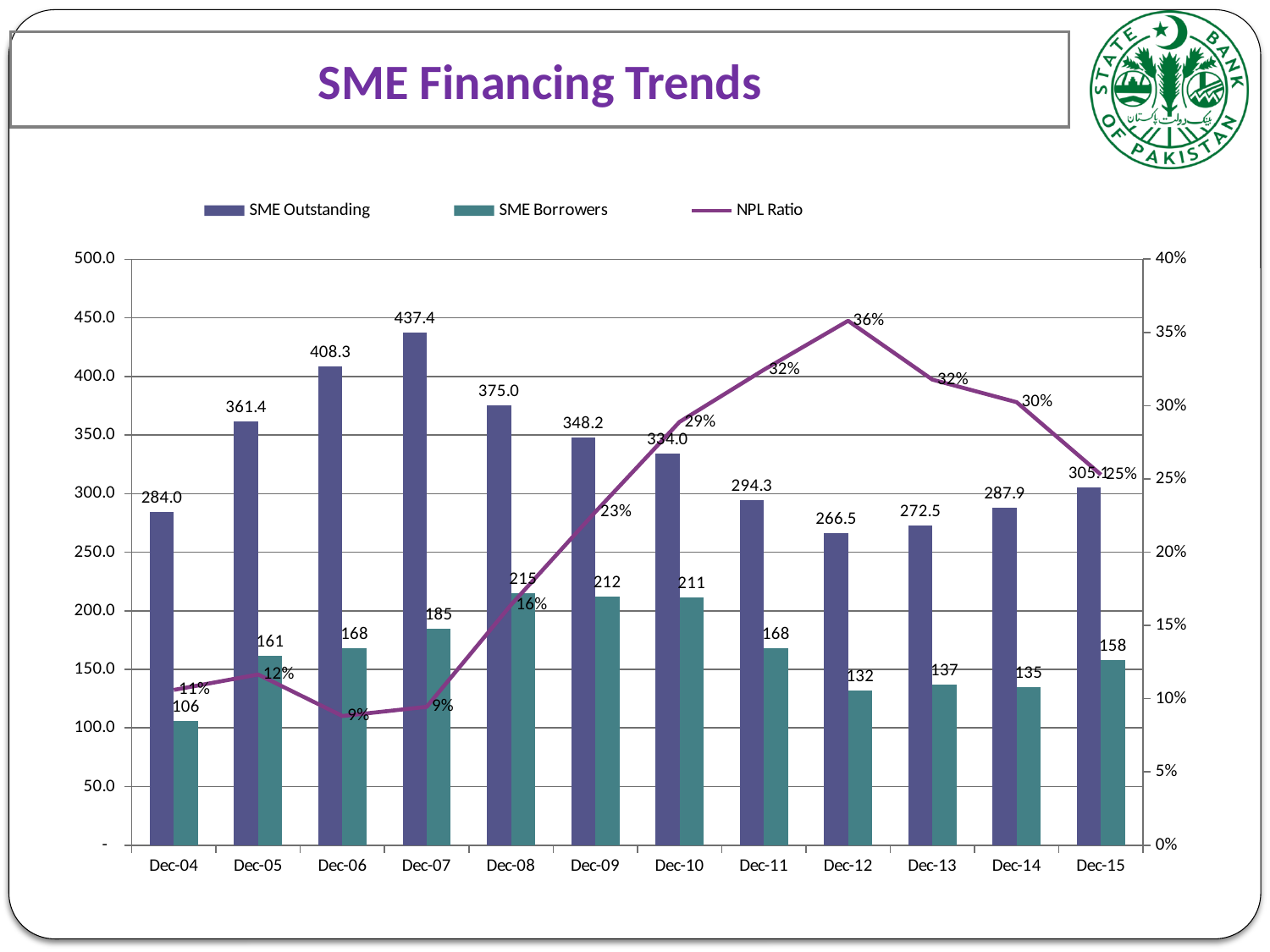
How many series does the legend list? 3 Does the NPL Ratio rise or fall from Dec-07 to Dec-12? Rise What is the NPL Ratio for Dec-12? 36% In which period does the NPL Ratio reach its peak? Dec-12 In which period is SME Borrowers lowest? Dec-04 What is the SME Outstanding value for Dec-07? 437.4 What kind of chart is shown on the slide? Combination bar and line chart How many periods are shown on the x axis? 12 In which period is SME Outstanding highest? Dec-07 Which period has the larger SME Borrowers value, Dec-11 or Dec-12? Dec-11 By how much did SME Outstanding increase from Dec-05 to Dec-06? 46.9 What is the SME Borrowers value for Dec-08? 215